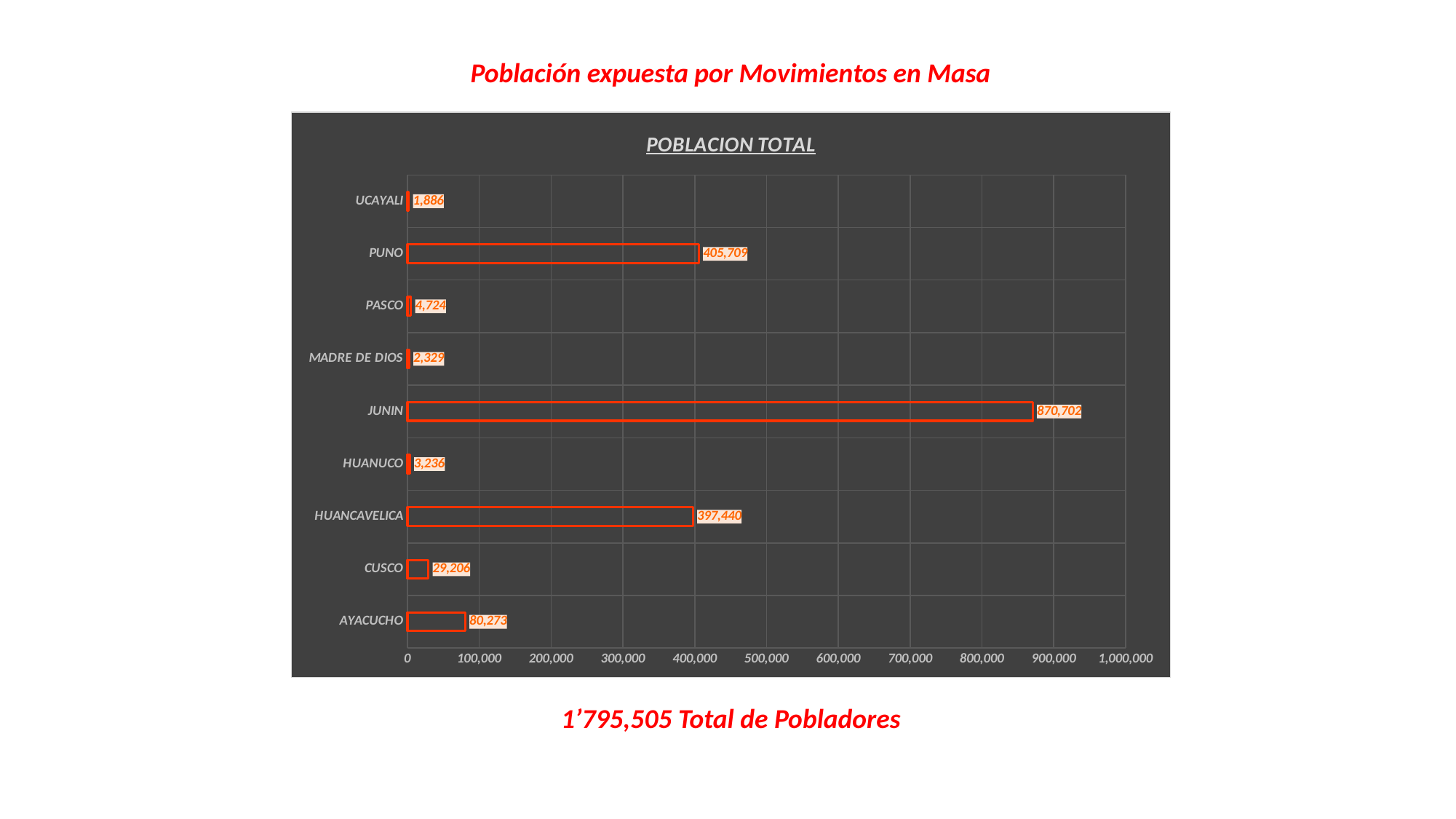
Which category has the lowest value? UCAYALI What kind of chart is shown on the slide? Bar chart What is the value for CUSCO? 29,206 Is the value for JUNIN greater or less than 800,000? greater What is the value for PUNO? 405,709 What is the difference between the values for AYACUCHO and CUSCO? 51,067 What is the difference between the values for JUNIN and PUNO? 464,993 How many categories are shown in the chart? 9 What is the value for MADRE DE DIOS? 2,329 Which is larger, the value for PUNO or the value for HUANCAVELICA? PUNO What is the value for JUNIN? 870,702 Which category has the highest value? JUNIN